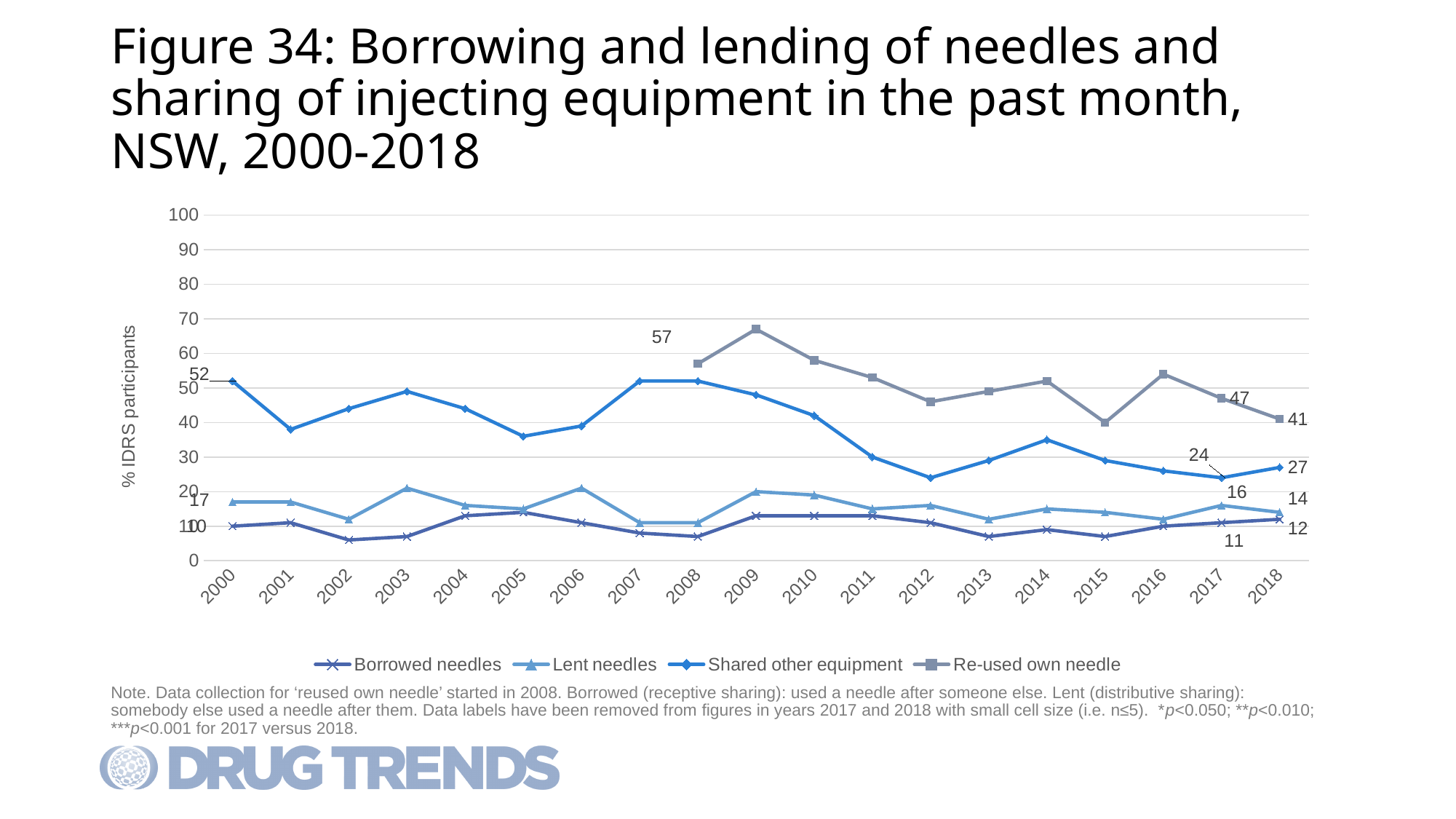
How many years are shown on the x axis? 19 What is the value for Lent needles in 2018? 14 What is the value for Shared other equipment in 2000? 52 What kind of chart is shown on the slide? Line chart Is the value for Re-used own needle in 2009 greater or less than 60? greater What is the difference between the Re-used own needle values in 2017 and 2018? 6 In 2018, which is larger: Shared other equipment or Lent needles? Shared other equipment What is the value for Re-used own needle in 2018? 41 How many series does the legend list? 4 What is the value for Re-used own needle in 2008? 57 Which series has the highest value in 2018? Re-used own needle What is the label on the y axis? % IDRS participants